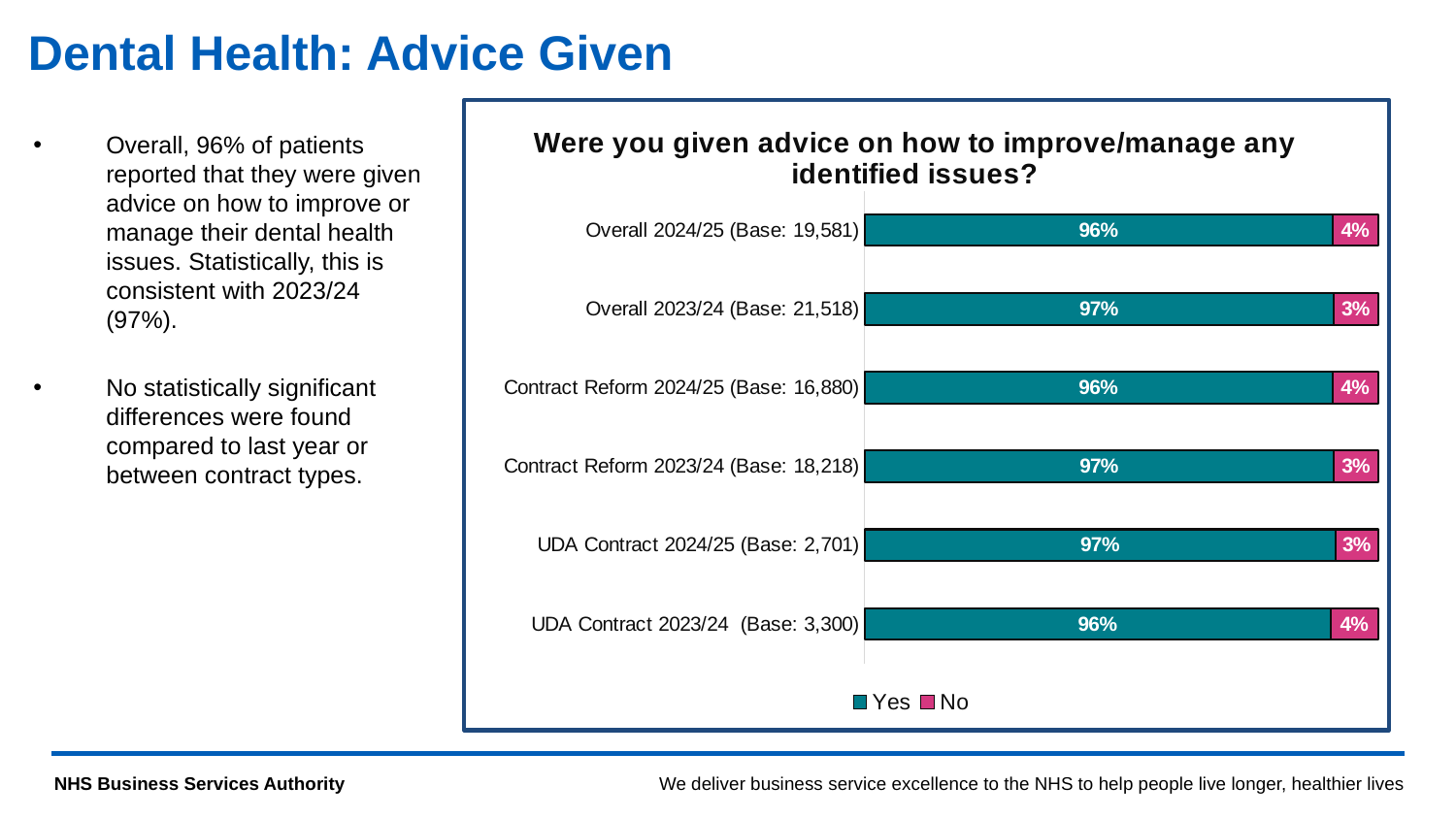
What kind of chart is shown on the slide? Stacked bar chart Which is larger, the Yes value for Contract Reform 2024/25 or the Yes value for Contract Reform 2023/24? Contract Reform 2023/24 What is the Yes value for UDA Contract 2024/25? 97% How many series does the legend list? 2 What is the total of the Yes and No values for the Overall 2024/25 bar? 100% What percentage of Overall 2024/25 respondents answered Yes? 96% What is the difference between the Yes values for Overall 2023/24 and Overall 2024/25? 1 percentage point What percentage of Overall 2023/24 respondents answered No? 3% What is the Yes value for Contract Reform 2023/24? 97% What is the No value for UDA Contract 2023/24? 4% What is the base (number of respondents) for Contract Reform 2024/25? 16,880 How many categories (bars) are shown in the chart? 6